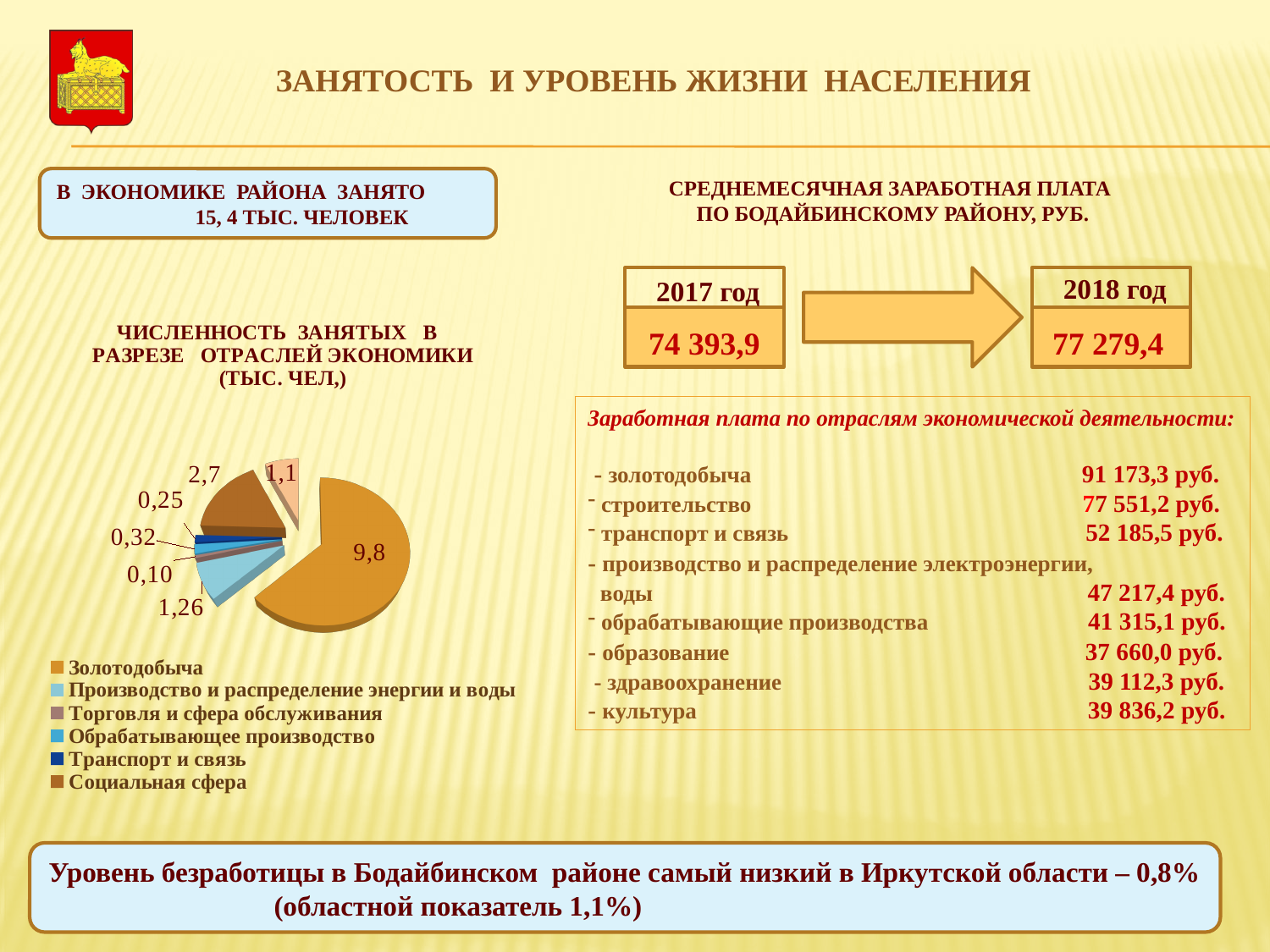
What is the smallest value labelled on the pie chart of employed by sector? 0,10 What unit is given in the title of the pie chart of employed by sector? тыс. чел. In the pie chart of employed by sector, what is the value for Производство и распределение энергии и воды? 1,26 In the pie chart of employed by sector, which is larger: Золотодобыча or Социальная сфера? Золотодобыча How many slices with data labels does the pie chart of employed by sector have? 7 Which sector has the largest slice in the pie chart of employed by sector? Золотодобыча What colour represents Золотодобыча in the pie chart of employed by sector? gold/orange In the pie chart of employed by sector, what is the value for Золотодобыча? 9,8 How many entries does the legend of the pie chart of employed by sector list? 6 In the pie chart of employed by sector, what is the difference between the values for Золотодобыча and Социальная сфера? 7,1 In the pie chart of employed by sector, what is the value for Социальная сфера? 2,7 What kind of chart is used to show the number of employed by economic sector (Численность занятых в разрезе отраслей экономики)? pie chart